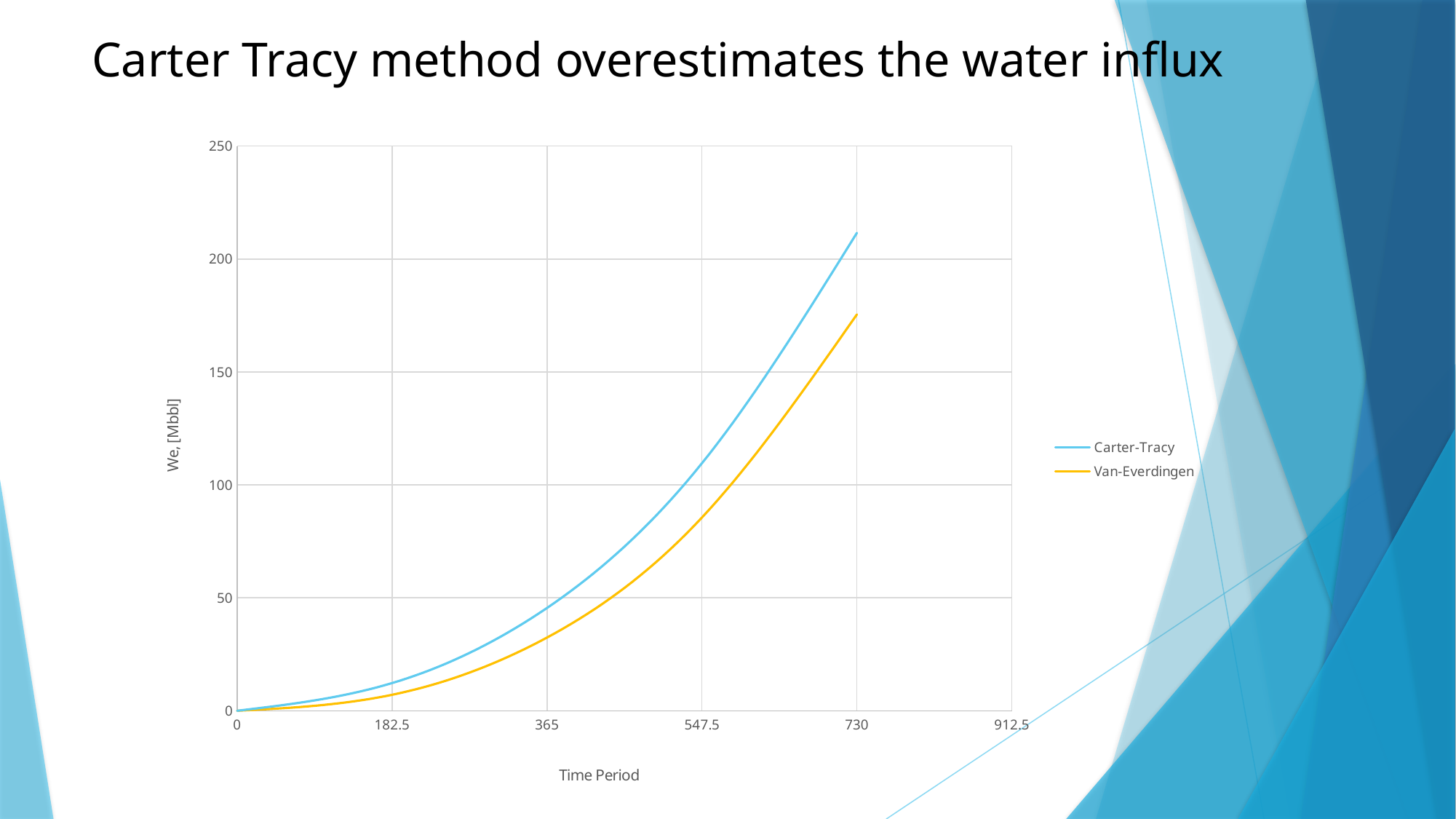
Do the values of the Carter-Tracy series rise or fall as the time period increases? rise Is the value of the Carter-Tracy series at a time period of 730 greater or less than 200? greater What are the two series named in the legend? Carter-Tracy and Van-Everdingen How many series does the legend list? 2 Do the values of the Van-Everdingen series rise or fall along the x axis? rise Is the value of the Van-Everdingen series at a time period of 730 greater or less than 200? less At a time period of 730, which series has the larger value, Carter-Tracy or Van-Everdingen? Carter-Tracy What is the label of the y axis? We, [Mbbl] Which series reaches the highest value on the chart? Carter-Tracy What kind of chart is shown on the slide? line chart Is the value of the Carter-Tracy series at a time period of 365 greater or less than 100? less